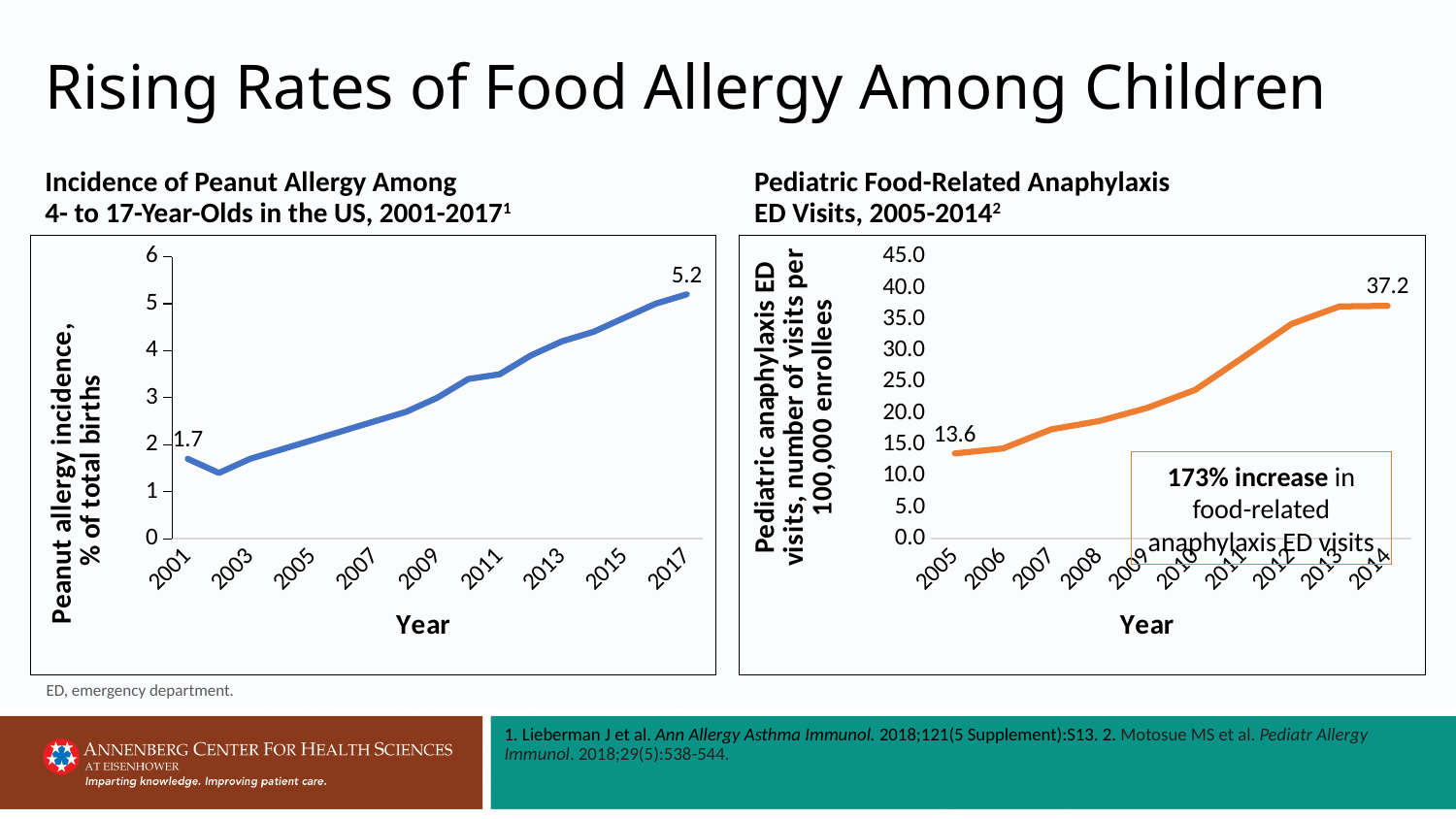
In the left chart (Incidence of Peanut Allergy Among 4- to 17-Year-Olds), by how much did the incidence increase from 2001 to 2017? 3.5 In the left chart (Incidence of Peanut Allergy Among 4- to 17-Year-Olds), what is the peanut allergy incidence in 2001? 1.7 In the left chart (Incidence of Peanut Allergy Among 4- to 17-Year-Olds), what kind of chart is shown? Line chart In the left chart (Incidence of Peanut Allergy Among 4- to 17-Year-Olds), what is the peanut allergy incidence in 2017? 5.2 In the right chart (Pediatric Food-Related Anaphylaxis ED Visits), what is the difference between the 2014 and 2005 values? 23.6 In the right chart (Pediatric Food-Related Anaphylaxis ED Visits), what percentage increase in food-related anaphylaxis ED visits is stated in the annotation? 173% increase In the right chart (Pediatric Food-Related Anaphylaxis ED Visits), what is the number of visits per 100,000 enrollees in 2005? 13.6 In the left chart (Incidence of Peanut Allergy Among 4- to 17-Year-Olds), do the values generally rise or fall from 2003 to 2017? Rise In the right chart (Pediatric Food-Related Anaphylaxis ED Visits), is the value for 2010 greater or less than 30.0? less In the left chart (Incidence of Peanut Allergy Among 4- to 17-Year-Olds), is the value for 2009 greater or less than 4? less In the right chart (Pediatric Food-Related Anaphylaxis ED Visits), how many years are shown on the x axis? 10 In the right chart (Pediatric Food-Related Anaphylaxis ED Visits), what is the number of visits per 100,000 enrollees in 2014? 37.2